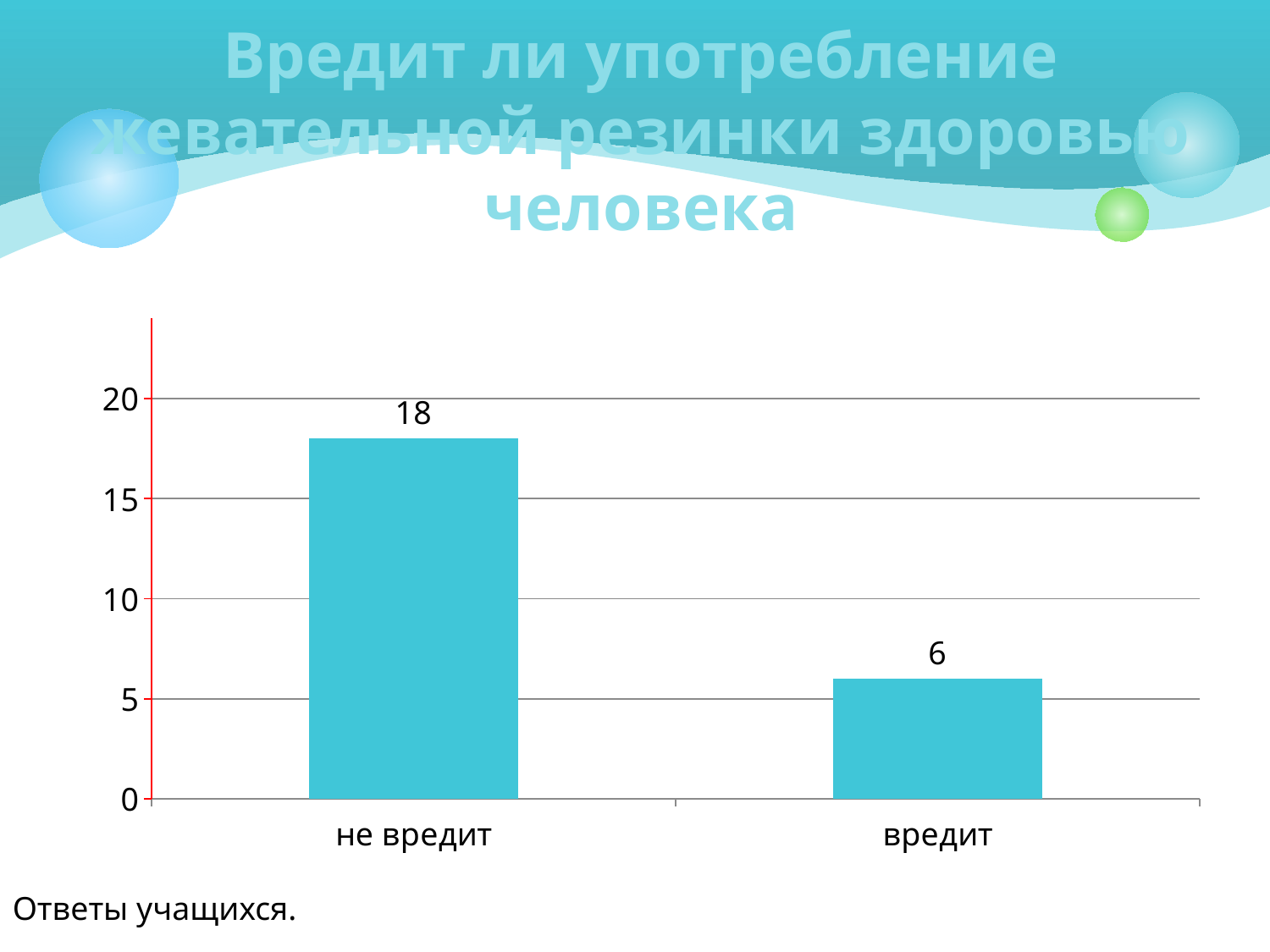
What is the value for "не вредит"? 18 Is the value for "не вредит" greater or less than 15? greater How many categories are shown on the chart? 2 Which category has the highest value? не вредит What is the difference between the values for "не вредит" and "вредит"? 12 What is the total of the two values shown on the chart? 24 What kind of chart is shown on the slide? bar chart Which category has the lowest value? вредит What is the value for "вредит"? 6 Which is larger, the value for "не вредит" or the value for "вредит"? не вредит What is the title of the slide? Вредит ли употребление жевательной резинки здоровью человека Is the value for "вредит" greater or less than 10? less